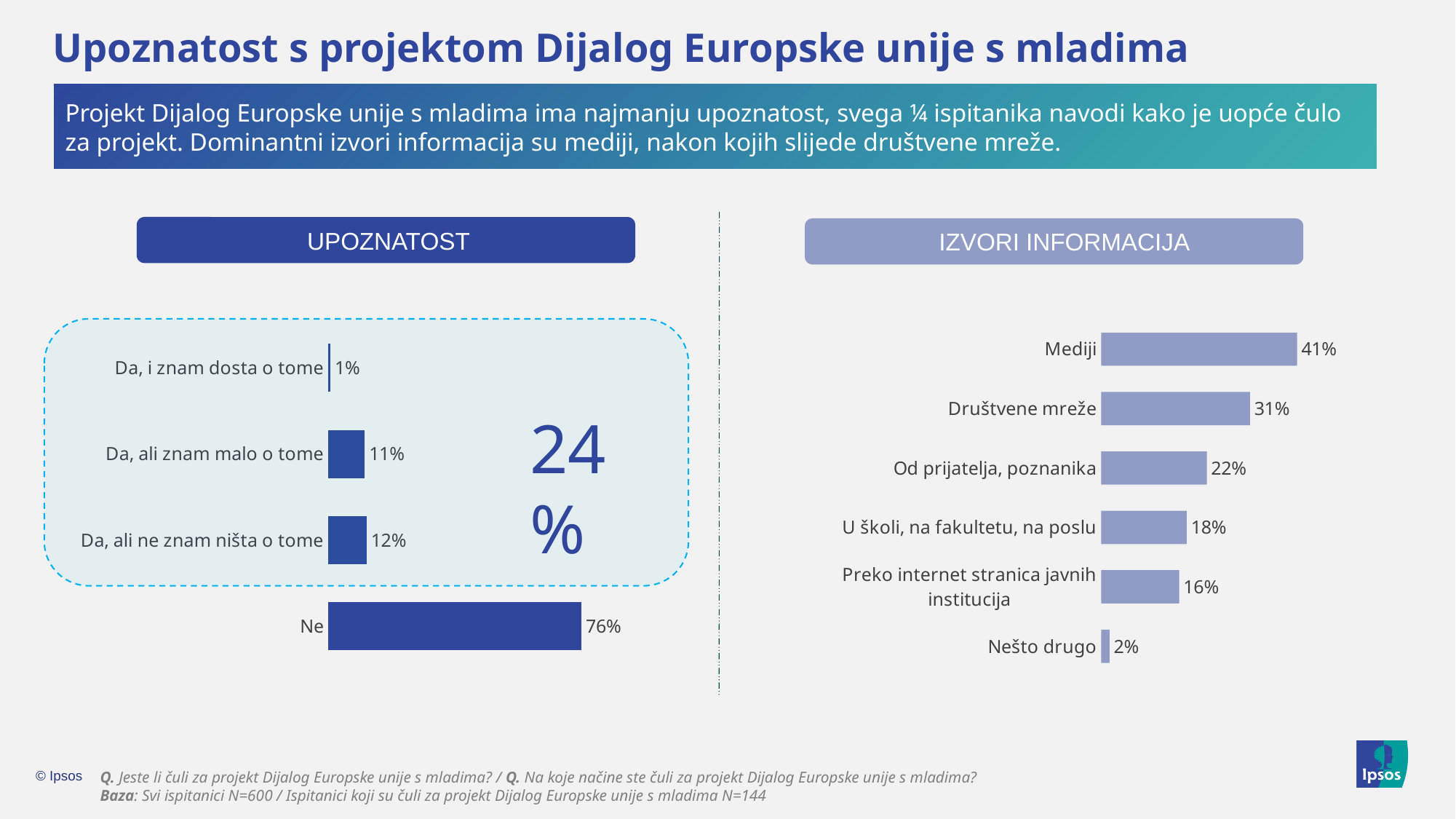
In the IZVORI INFORMACIJA chart, what is the value for "Mediji"? 41% In the IZVORI INFORMACIJA chart, which is larger: "Društvene mreže" or "Od prijatelja, poznanika"? Društvene mreže What type of chart is the IZVORI INFORMACIJA chart? Bar chart In the IZVORI INFORMACIJA chart, what is the difference between "Mediji" and "Društvene mreže"? 10% In the IZVORI INFORMACIJA chart, how many categories are shown? 6 In the UPOZNATOST chart, what is the difference between "Ne" and "Da, ali ne znam ništa o tome"? 64% In the UPOZNATOST chart, what is the value for "Ne"? 76% In the UPOZNATOST chart, which category has the lowest value? Da, i znam dosta o tome In the UPOZNATOST chart, what is the value for "Da, ali znam malo o tome"? 11% In the UPOZNATOST chart, how many categories are shown? 4 In the IZVORI INFORMACIJA chart, which category has the highest value? Mediji In the IZVORI INFORMACIJA chart, what is the value for "Preko internet stranica javnih institucija"? 16%